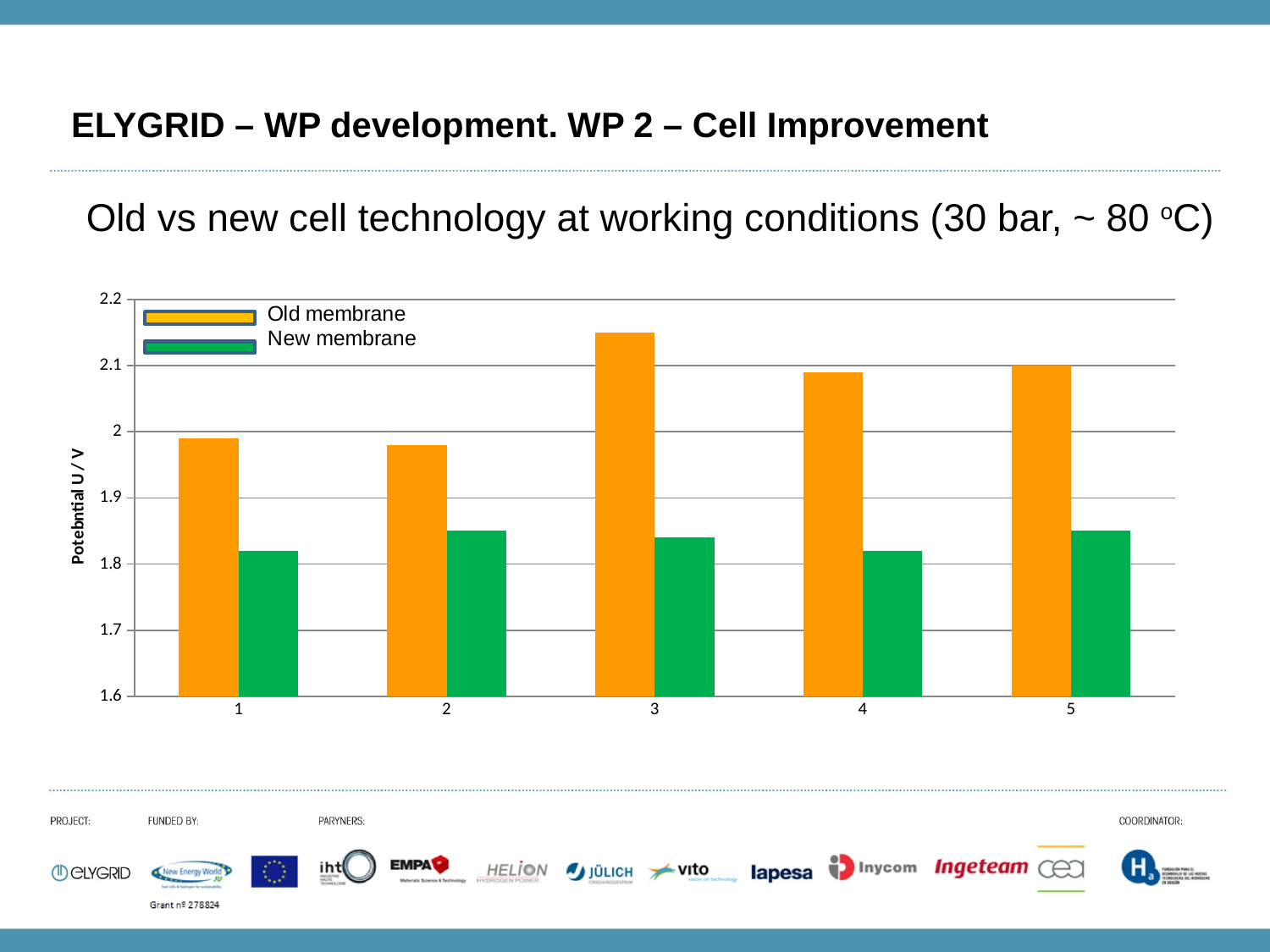
For category 3, which series has the larger value, Old membrane or New membrane? Old membrane Is the New membrane value for category 1 greater or less than 1.9? less Is the New membrane value for category 2 greater or less than 1.8? greater How many series does the legend list? 2 Is the Old membrane value for category 4 greater or less than 2? greater Which is larger, the Old membrane value for category 1 or for category 4? category 4 How many categories are shown on the x axis? 5 Which category has the highest Old membrane value? 3 What kind of chart is shown on the slide? bar chart What are the two entries in the legend? Old membrane, New membrane What colour are the New membrane bars? green